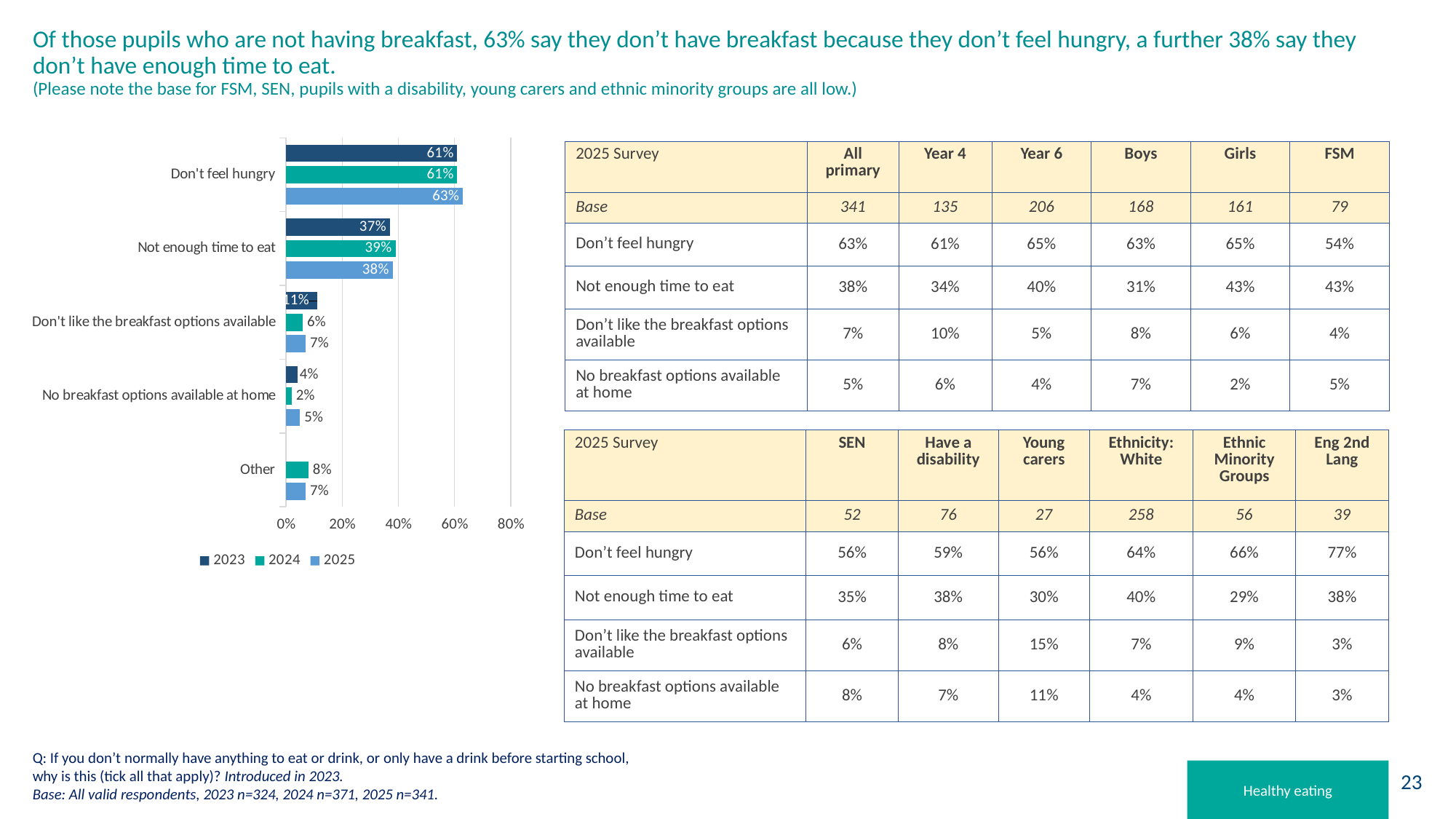
What is the 2024 value for 'No breakfast options available at home' in the chart? 2% What is the 2025 value for 'Don't feel hungry' in the chart? 63% What is the 2023 value for 'Don't like the breakfast options available' in the chart? 11% Which series in the chart legend is shown in the darkest blue colour? 2023 Which category has the lowest 2024 value in the chart? No breakfast options available at home Which category has the highest 2025 value in the chart? Don't feel hungry Which is larger in the chart: the 2023 value or the 2025 value for 'Not enough time to eat'? 2025 How many categories are shown on the chart's vertical axis? 5 What is the 2024 value for 'Not enough time to eat' in the chart? 39% What is the difference between the 2023 and 2024 values for 'Don't like the breakfast options available'? 5% What kind of chart is shown on the slide? bar chart How many series does the chart legend list? 3